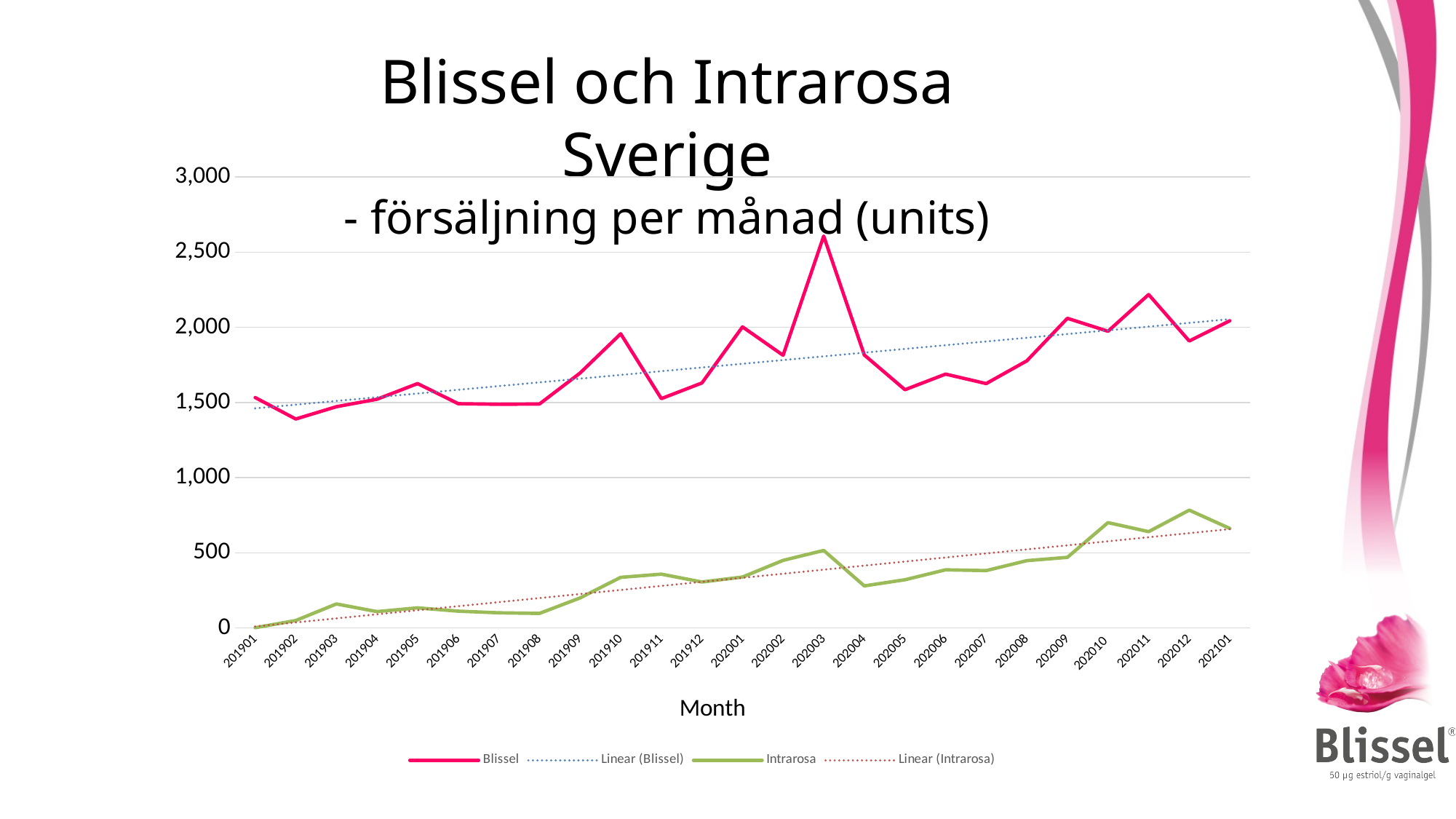
Does the Intrarosa series generally rise or fall from 201901 to 202101? Rise Is the value for Intrarosa in 202010 greater or less than 500? greater What is the title of the x axis? Month Is the value for Blissel in 202003 greater or less than 2,000? greater Is the value for Intrarosa in 202004 greater or less than 500? less In which month does the Blissel series reach its lowest value? 201902 How many entries does the chart legend list? 4 What kind of chart is shown on the slide? Line chart In which month does the Blissel series reach its highest value? 202003 Which series has the higher value in 202101, Blissel or Intrarosa? Blissel How many months are plotted along the x axis? 25 In which month does the Intrarosa series reach its highest value? 202012